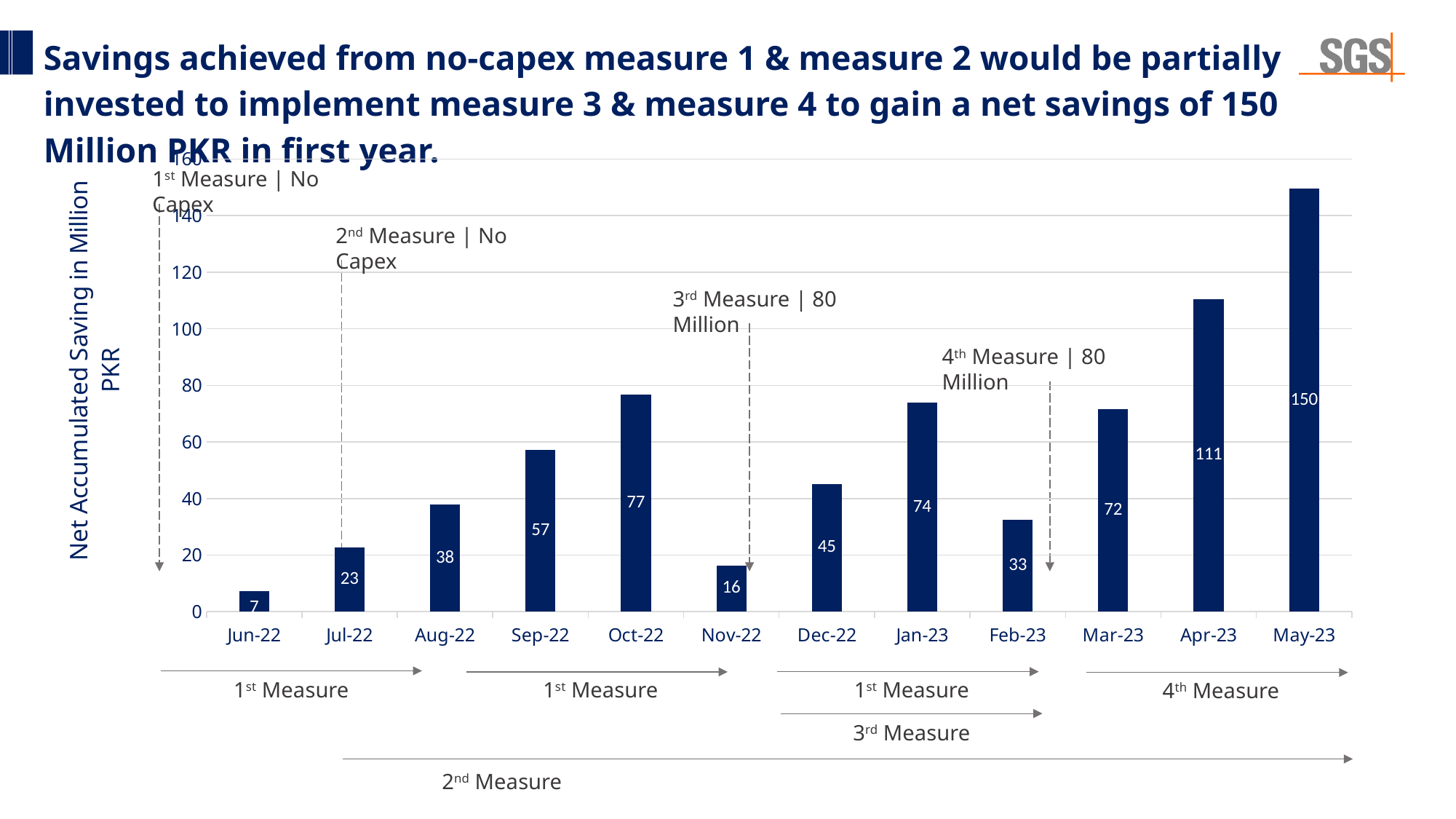
Which is larger, the value for Jan-23 or the value for Mar-23? Jan-23 What is the net accumulated saving for Oct-22? 77 How many months are shown on the x axis? 12 Which month has the highest net accumulated saving? May-23 What is the difference between the values for May-23 and Apr-23? 39 What is the net accumulated saving for Nov-22? 16 What is the net accumulated saving for Apr-23? 111 What is the difference between the values for Oct-22 and Nov-22? 61 Is the value for Apr-23 greater or less than 100? greater What type of chart is shown on the slide? Bar chart Which month has the lowest net accumulated saving? Jun-22 What is the label of the vertical axis? Net Accumulated Saving in Million PKR